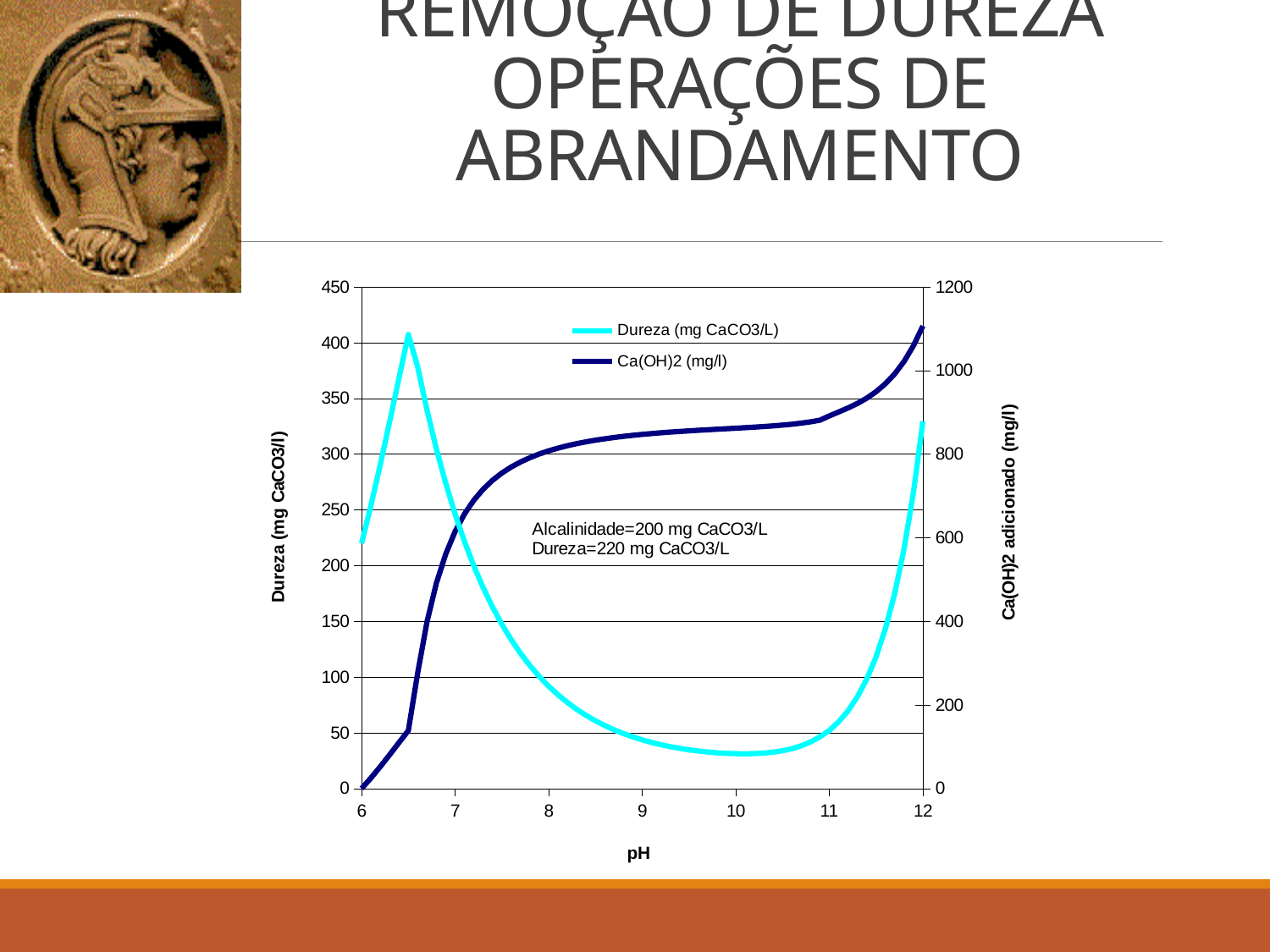
Is the Ca(OH)2 (mg/l) value at pH 6.5 greater or less than 200? less Is the Ca(OH)2 (mg/l) value at pH 9 greater or less than 800? greater What is the label of the x axis of the chart? pH Is the Ca(OH)2 (mg/l) value at pH 12 greater or less than 1000? greater Does the Ca(OH)2 (mg/l) series rise or fall as pH increases from 6 to 12? rises Does the Dureza (mg CaCO3/L) series rise or fall as pH increases from 7 to 10? falls What is the range of the pH axis shown on the chart? 6 to 12 What kind of chart is shown on the slide? line chart How many series does the chart legend list? 2 What is the title of the right-hand vertical axis? Ca(OH)2 adicionado (mg/l)